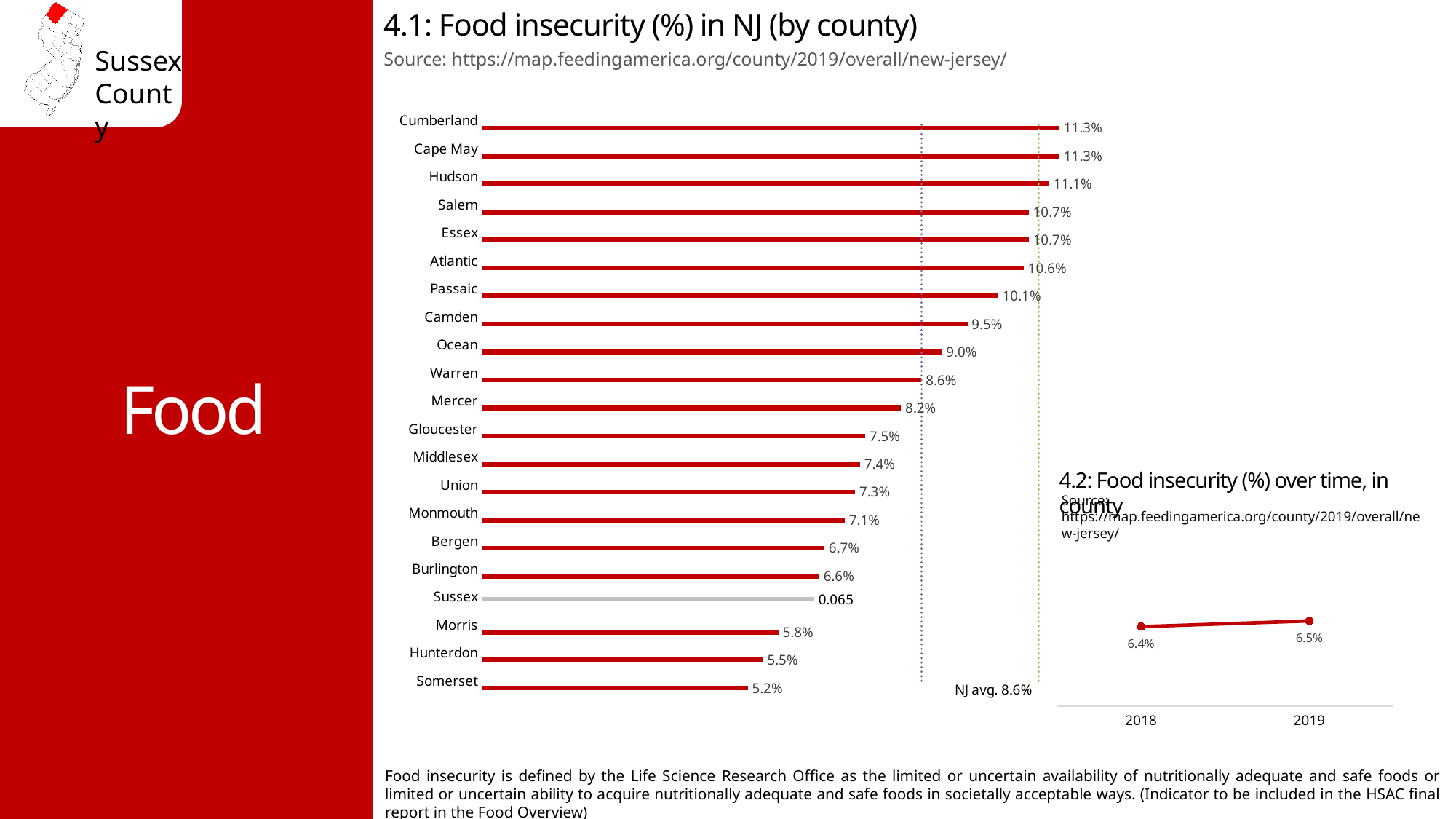
In chart 4.1 (Food insecurity (%) in NJ by county), what label is shown for Sussex? 0.065 In chart 4.1 (Food insecurity (%) in NJ by county), what is the value for Hudson? 11.1% In chart 4.1 (Food insecurity (%) in NJ by county), which county has the lowest value? Somerset In chart 4.1 (Food insecurity (%) in NJ by county), which is larger, Mercer or Gloucester? Mercer In chart 4.1 (Food insecurity (%) in NJ by county), what is the difference between Camden and Ocean? 0.5% In chart 4.2 (Food insecurity (%) over time, in county), what is the value for 2018? 6.4% In chart 4.1 (Food insecurity (%) in NJ by county), what NJ average value is labelled on the chart? 8.6% In chart 4.1 (Food insecurity (%) in NJ by county), what is the value for Passaic? 10.1% In chart 4.2 (Food insecurity (%) over time, in county), does the value rise or fall from 2018 to 2019? Rise What kind of chart is chart 4.1 (Food insecurity (%) in NJ by county)? Bar chart How many counties are shown in chart 4.1 (Food insecurity (%) in NJ by county)? 21 In chart 4.2 (Food insecurity (%) over time, in county), what is the difference between 2019 and 2018? 0.1%